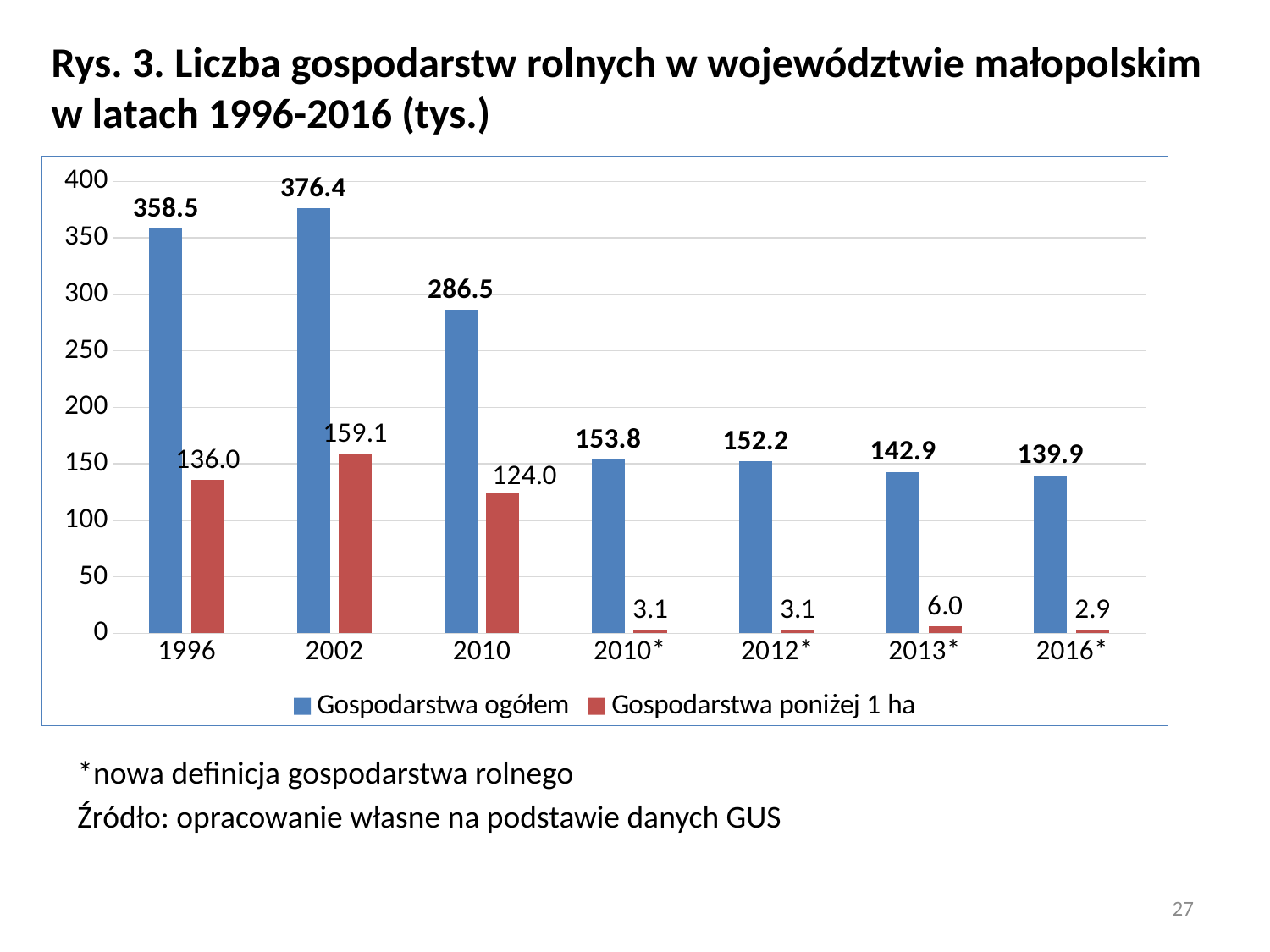
What is the value of Gospodarstwa ogółem for 2002? 376.4 Does the value of Gospodarstwa ogółem rise or fall from 2010* to 2016*? fall What kind of chart is shown on the slide? bar chart What is the value of Gospodarstwa poniżej 1 ha for 1996? 136.0 What is the difference between Gospodarstwa ogółem in 2002 and in 2010? 89.9 What colour are the bars for Gospodarstwa poniżej 1 ha? red Which year has the lowest value for Gospodarstwa poniżej 1 ha? 2016* How many year categories are shown on the x axis? 7 Which year has the highest value for Gospodarstwa ogółem? 2002 What is the value of Gospodarstwa poniżej 1 ha for 2013*? 6.0 Which is larger: Gospodarstwa poniżej 1 ha in 2002 or in 2010? 2002 How many series does the legend list? 2